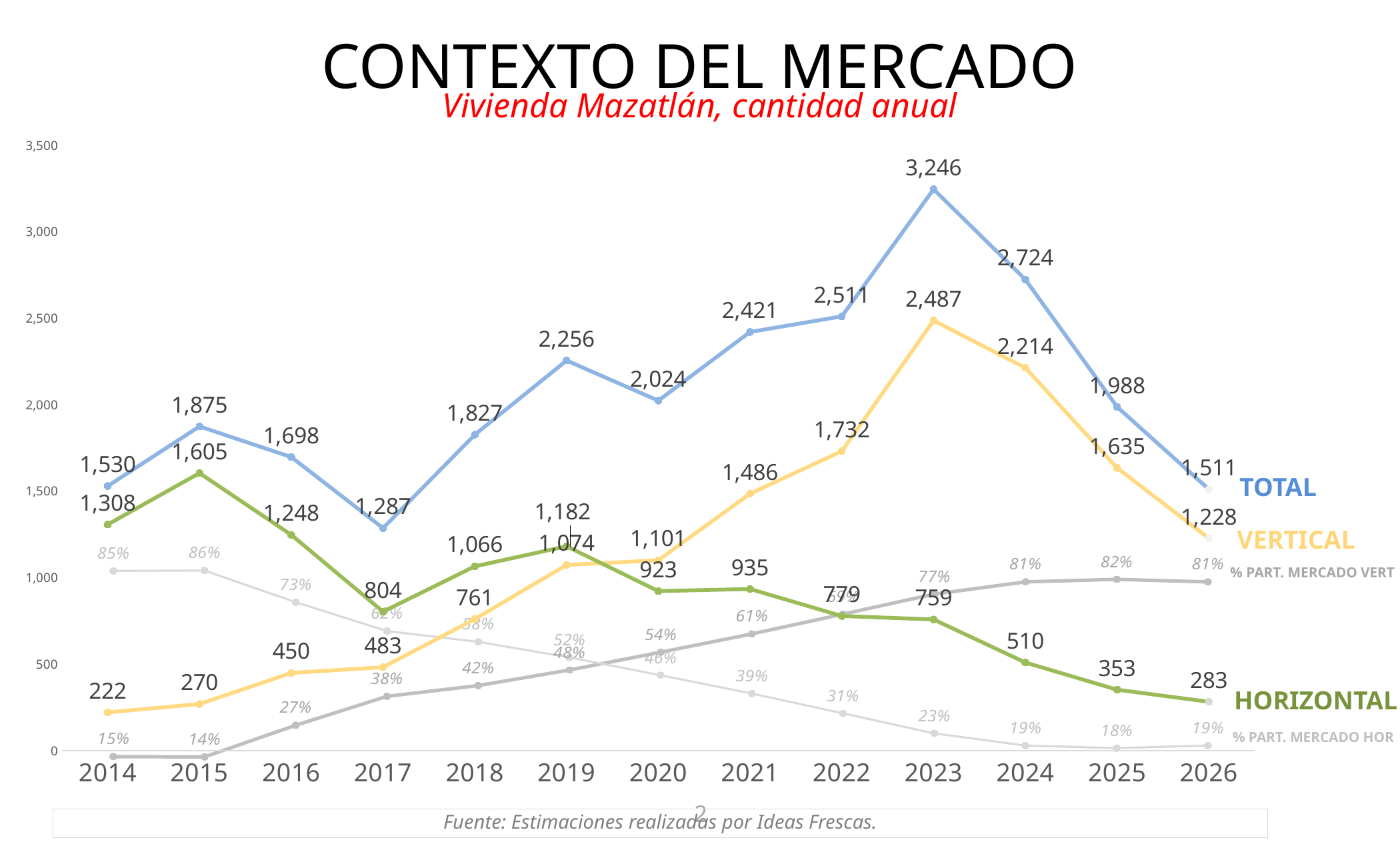
What is the TOTAL value for 2023? 3,246 Does the HORIZONTAL series rise or fall from 2023 to 2026? Fall How many years are shown on the x axis? 13 What is the VERTICAL value for 2026? 1,228 What is the difference between the TOTAL values for 2023 and 2024? 522 In which year does the TOTAL series reach its highest value? 2023 What is the % PART. MERCADO VERT value for 2025? 82% Which is larger in 2019, the VERTICAL value or the HORIZONTAL value? HORIZONTAL What kind of chart is shown on the slide? Line chart What is the HORIZONTAL value for 2015? 1,605 Is the HORIZONTAL value for 2024 greater or less than 500? greater In which year is the VERTICAL series at its lowest value? 2014